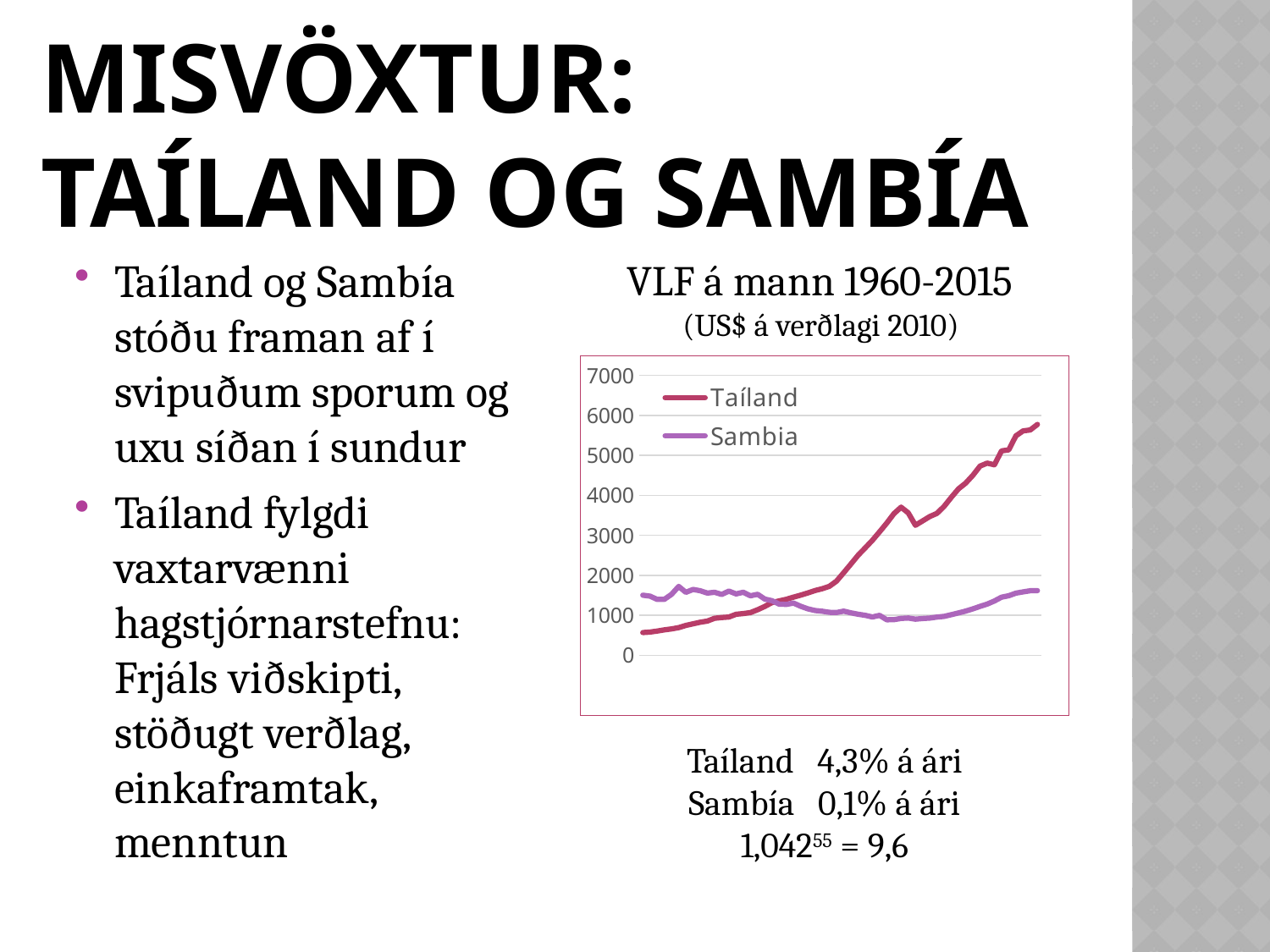
At the left end of the chart, which series has the larger value, Taíland or Sambia? Sambia At the right end of the chart, which series has the larger value, Taíland or Sambia? Taíland Is the starting value of the Taíland line greater or less than 1000? less How many series does the chart's legend list? 2 Which series reaches the highest value on the chart, Taíland or Sambia? Taíland What kind of chart is shown on the slide? line chart What is the highest value shown on the chart's vertical axis? 7000 Is the final value of the Taíland line greater or less than 5000? greater What is the title of the chart? VLF á mann 1960-2015 (US$ á verðlagi 2010) Does the Taíland line rise or fall overall from left to right? rise Is the final value of the Sambia line greater or less than 2000? less What are the two series named in the chart's legend? Taíland and Sambia